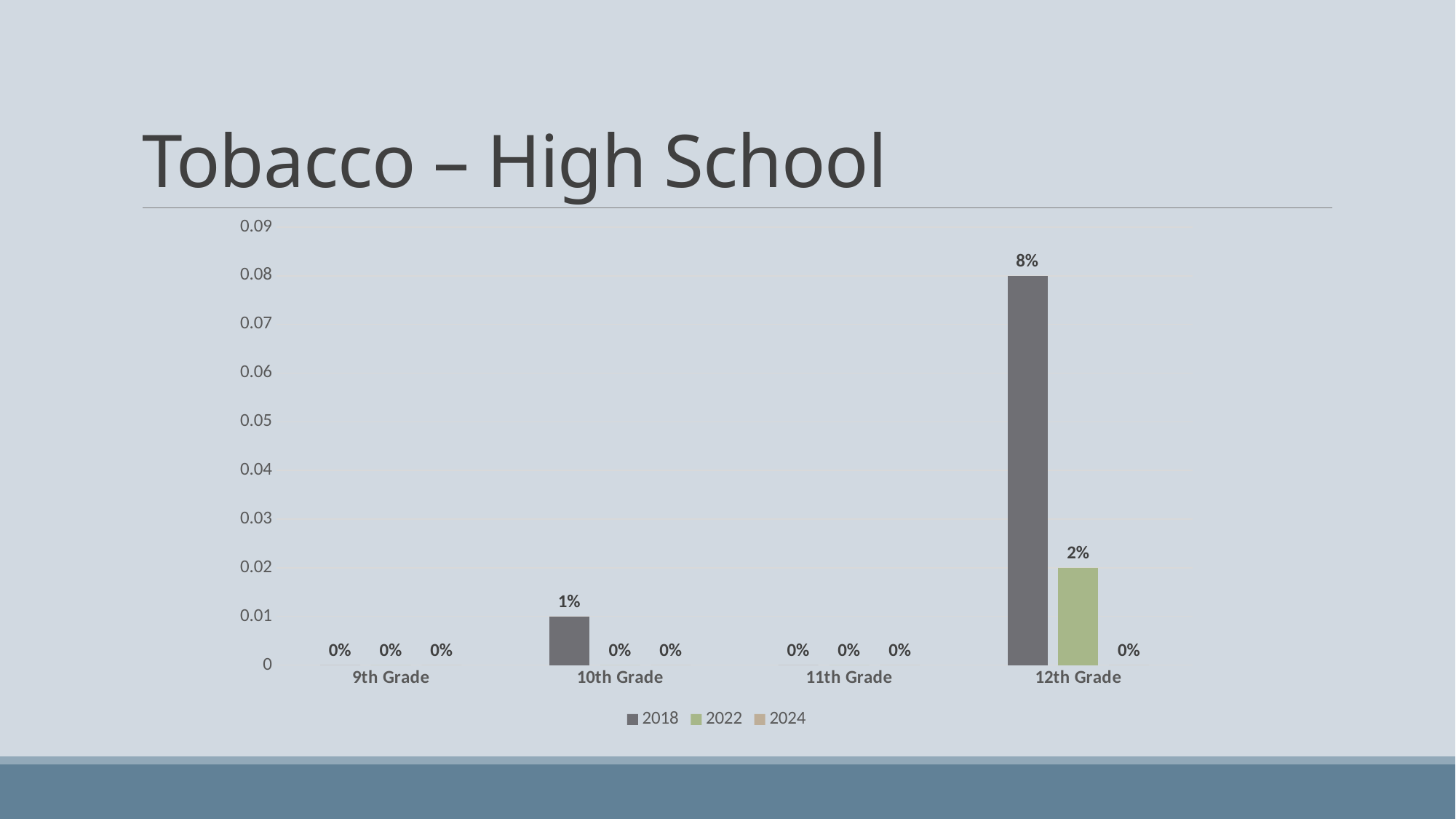
How many grade categories are shown on the x axis? 4 What is the value for 2018 in 10th Grade? 1% Which grade has the highest value for 2018? 12th Grade What is the value for 2018 in 12th Grade? 8% What is the difference between the 2018 and 2022 values in 12th Grade? 6% What is the value for 2024 in 12th Grade? 0% Which is larger in 12th Grade, the 2018 value or the 2022 value? 2018 What is the title of the slide? Tobacco – High School What is the value for 2022 in 12th Grade? 2% What kind of chart is shown on the slide? Bar chart How many series does the legend list? 3 Which years are listed in the legend? 2018, 2022, 2024